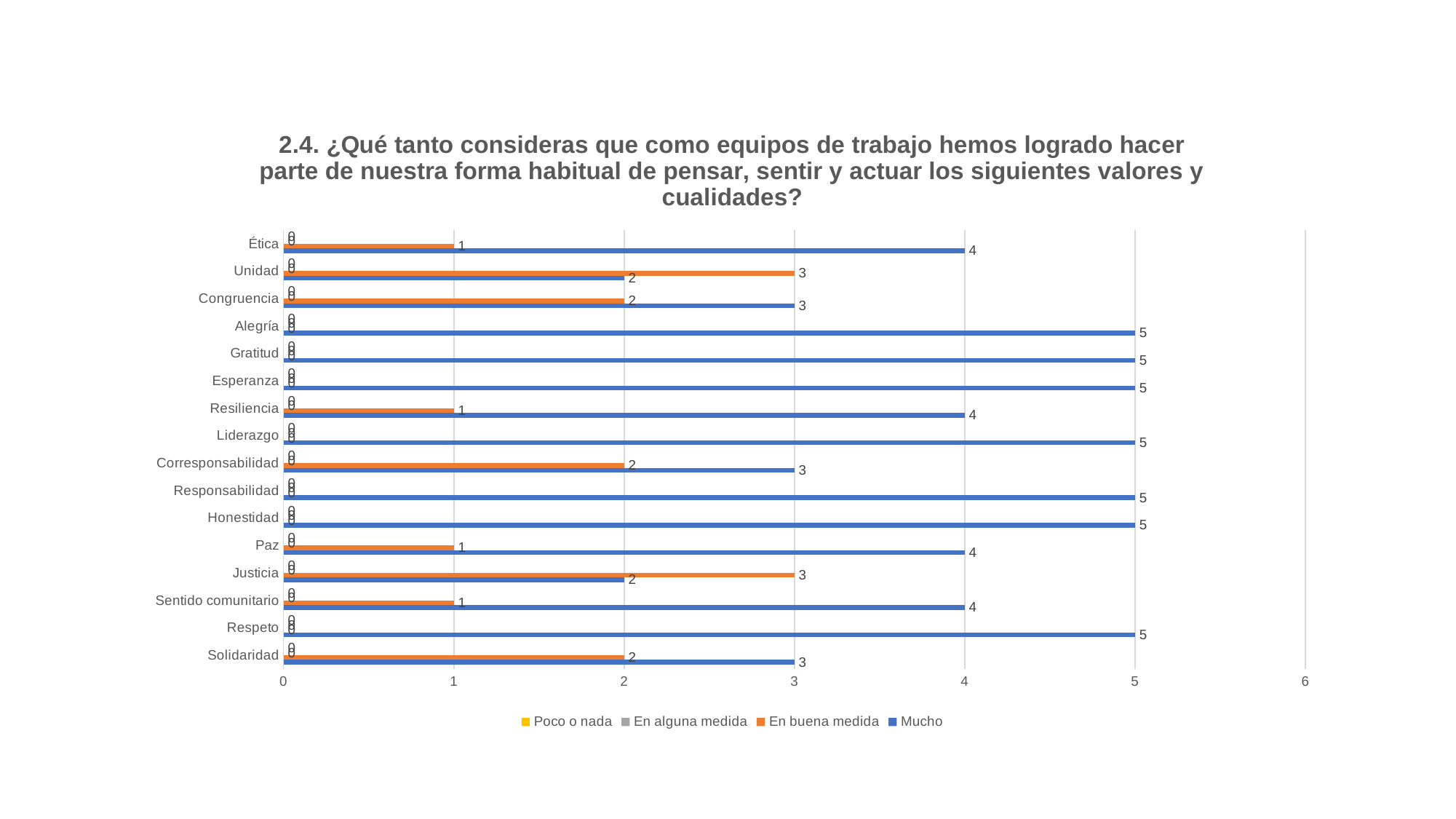
What is the value of "Mucho" for Solidaridad? 3 What type of chart is shown on the slide? bar chart How many series does the legend list? 4 How many categories (values/qualities) are plotted on the chart? 16 What is the value of "Mucho" for Ética? 4 For Justicia, which is larger: "En buena medida" or "Mucho"? En buena medida What is the total of the "En buena medida" and "Mucho" values for Corresponsabilidad? 5 What is the value of "Poco o nada" for Gratitud? 0 What is the value of "En buena medida" for Paz? 1 Which series is shown in orange in the legend? En buena medida What is the difference between the "Mucho" value for Respeto and the "Mucho" value for Congruencia? 2 What is the value of "En buena medida" for Unidad? 3